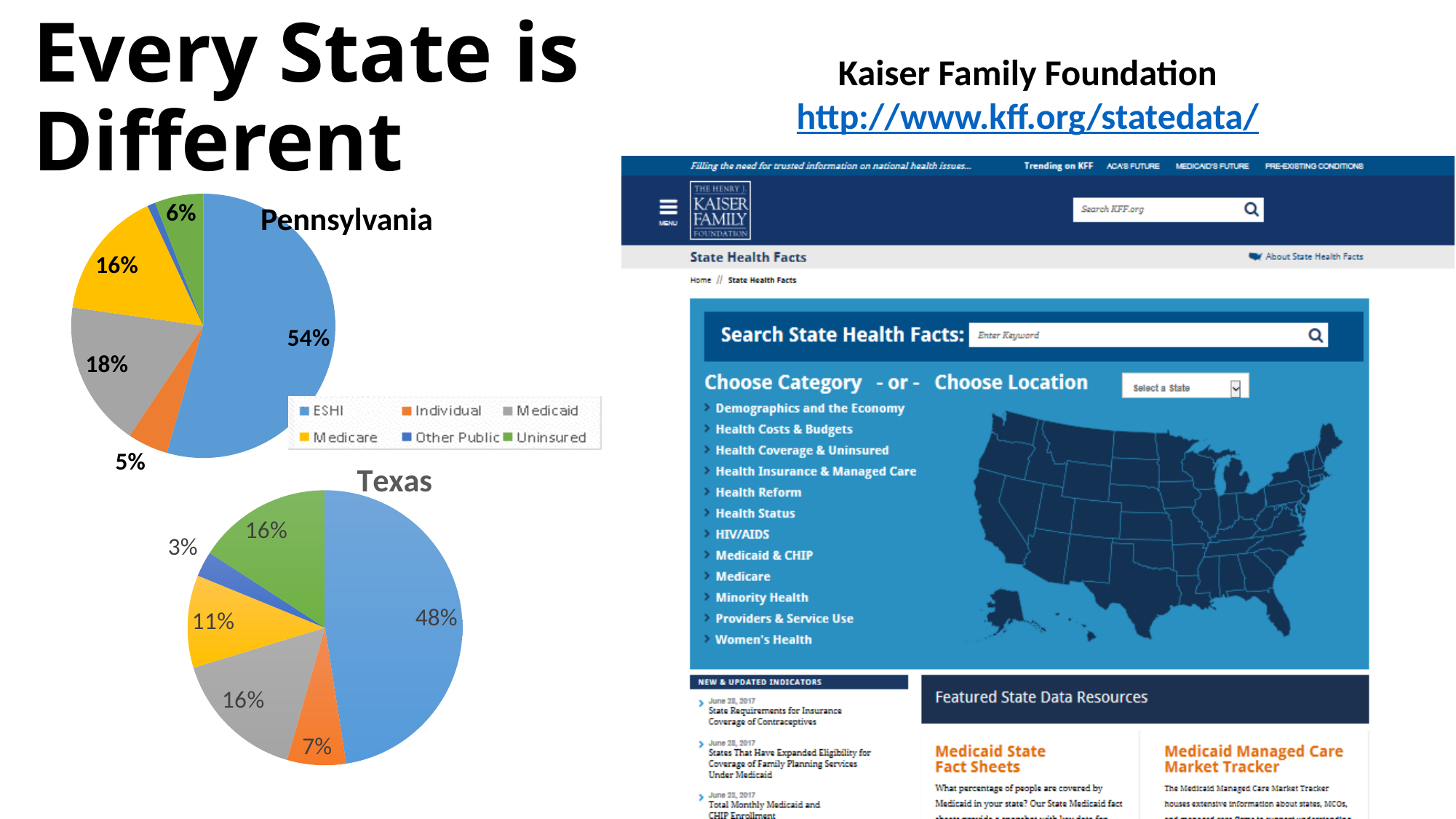
In the Pennsylvania pie chart, what share is ESHI? 54% What type of chart is used for Pennsylvania and Texas? Pie chart How many categories does the legend list for the pie charts? 6 In the Texas pie chart, which category has the largest slice? ESHI In the Pennsylvania pie chart, what share is Medicaid? 18% In the Texas pie chart, what share is Uninsured? 16% In the Texas pie chart, which category has the smallest slice? Other Public In the legend, which colour represents Medicare? Yellow In the Pennsylvania pie chart, which category has the smallest slice? Other Public Which state has a larger Uninsured share, Pennsylvania or Texas? Texas In the Texas pie chart, what share is Medicare? 11% What is the difference between the ESHI share in Pennsylvania and the ESHI share in Texas? 6%